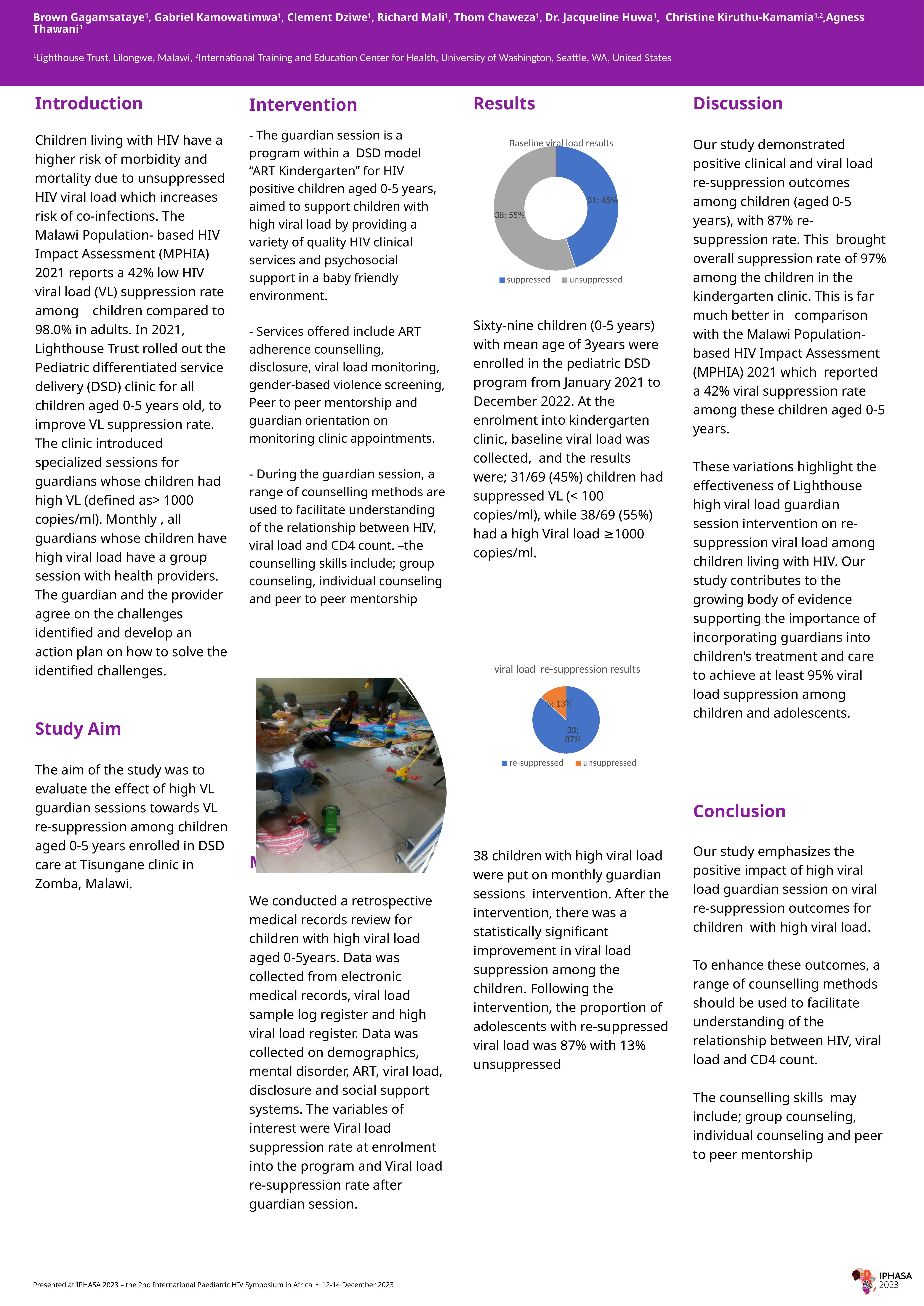
In the 'Baseline viral load results' chart, how many categories does the legend list? 2 In the 'Baseline viral load results' chart, what is the value shown for unsuppressed? 38; 55% In the 'Baseline viral load results' chart, what is the difference in count between unsuppressed and suppressed children? 7 What kind of chart is the 'viral load re-suppression results' chart? pie chart In the 'viral load re-suppression results' chart, what is the value shown for unsuppressed? 5; 13% In the 'viral load re-suppression results' chart, what colour is the unsuppressed slice? orange In the 'viral load re-suppression results' chart, what is the difference in count between re-suppressed and unsuppressed children? 28 In the 'viral load re-suppression results' chart, what is the value shown for re-suppressed? 33; 87% In the 'Baseline viral load results' chart, what is the value shown for suppressed? 31; 45% In the 'Baseline viral load results' chart, what share of the chart does the suppressed slice represent? 45% In the 'viral load re-suppression results' chart, which category has the smaller share? unsuppressed In the 'Baseline viral load results' chart, which category has the larger share? unsuppressed